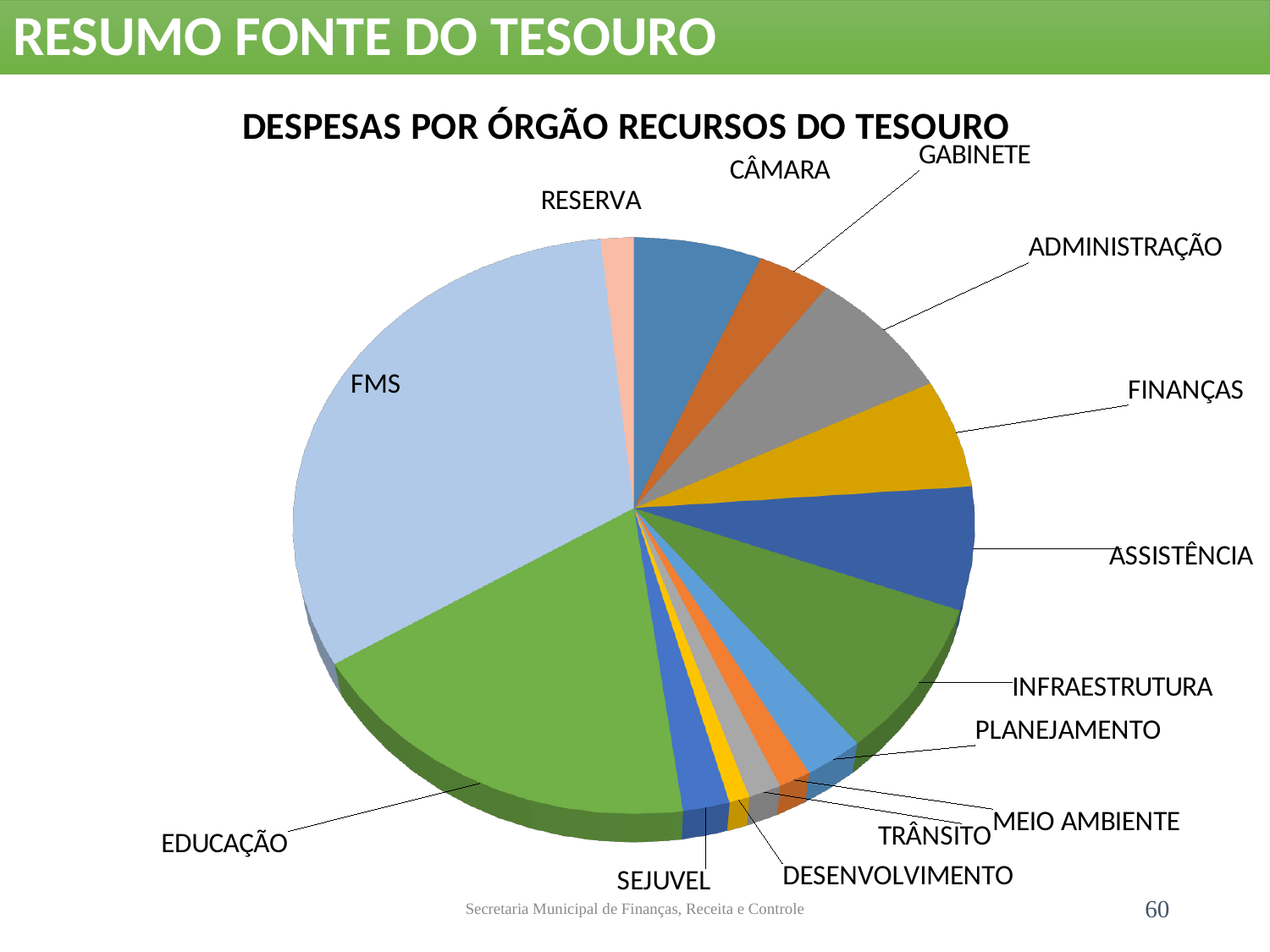
How many slices (categories) does the pie chart have? 14 Which category is the second-largest slice of the pie? EDUCAÇÃO What is the title of the chart? DESPESAS POR ÓRGÃO RECURSOS DO TESOURO Which slice is larger, ADMINISTRAÇÃO or RESERVA? ADMINISTRAÇÃO What kind of chart is shown on the slide? pie chart Which slice is larger, FMS or EDUCAÇÃO? FMS Which slice is larger, INFRAESTRUTURA or PLANEJAMENTO? INFRAESTRUTURA Which category has the largest slice of the pie? FMS What colour is the EDUCAÇÃO slice? green